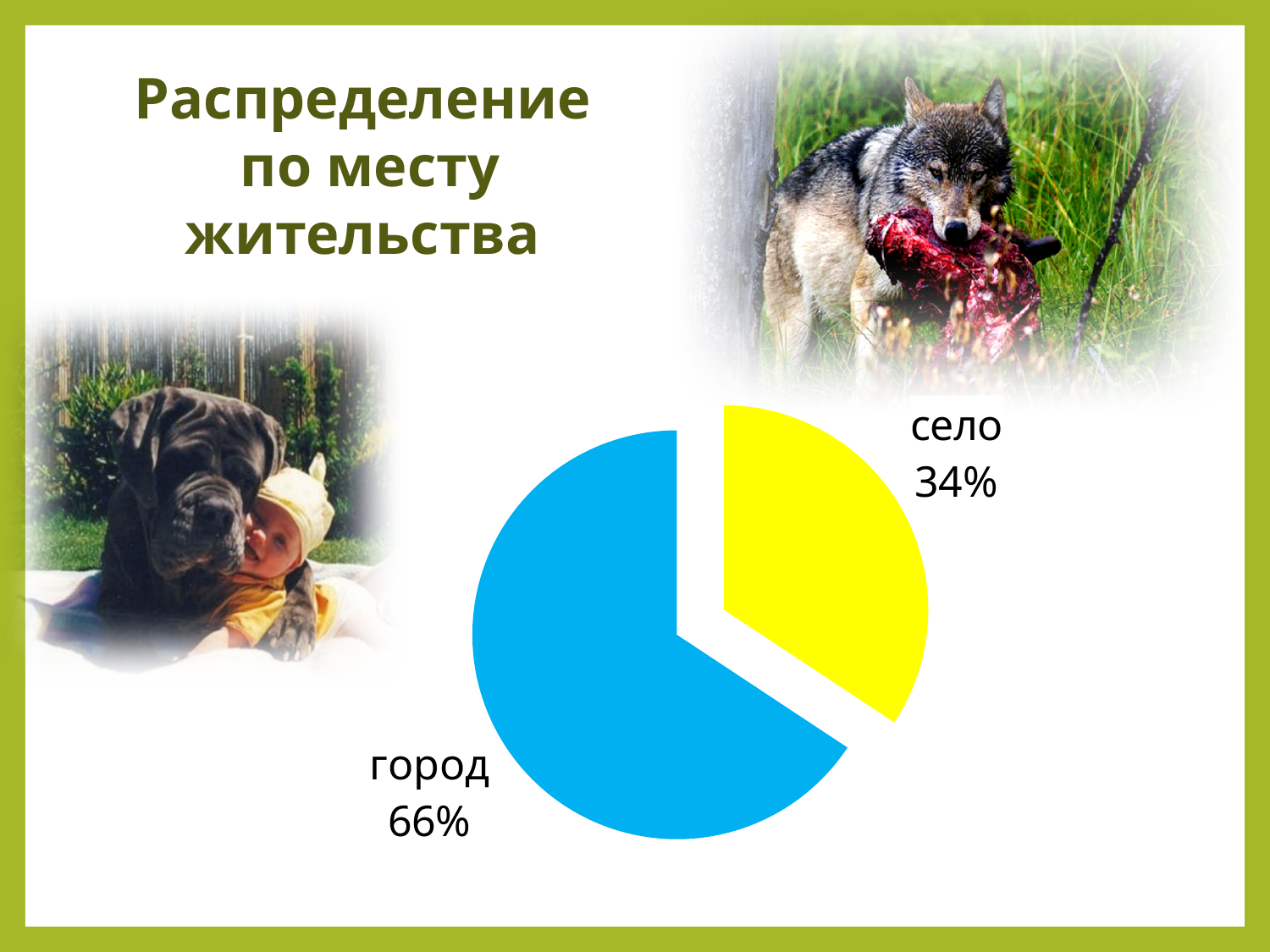
What share of the pie does город represent? 66% Is the share for город greater or less than 50%? greater What is the title of the slide containing the chart? Распределение по месту жительства What is the total of the two slices shown in the pie chart? 100% What colour is the slice for село? yellow What is the difference in percentage points between город and село? 32 What share of the pie does село represent? 34% What kind of chart is shown on the slide? pie chart Which category has the smallest slice of the pie? село How many slices does the pie chart have? 2 Which is larger, the share for город or the share for село? город Which category has the largest slice of the pie? город